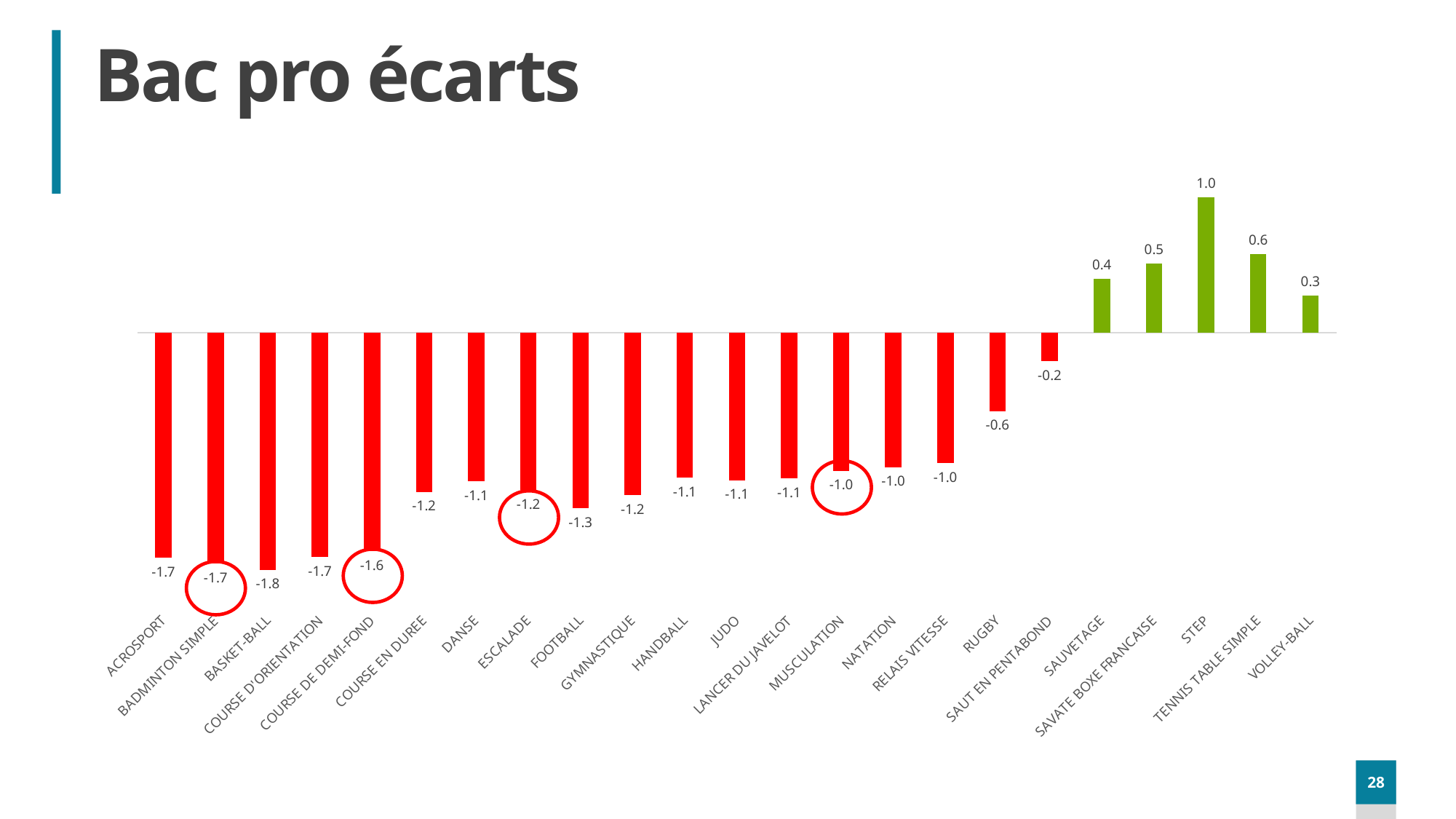
What is the value for RUGBY? -0.6 What is the value for SAUT EN PENTABOND? -0.2 Which category has the lowest value? BASKET-BALL How many categories are shown on the chart? 23 What is the value for FOOTBALL? -1.3 What is the title of the slide? Bac pro écarts What kind of chart is shown on the slide? bar chart Which category has the highest value? STEP Which has a larger value, SAUVETAGE or TENNIS TABLE SIMPLE? TENNIS TABLE SIMPLE What is the value for BASKET-BALL? -1.8 What is the difference between the values for STEP and VOLLEY-BALL? 0.7 What is the value for STEP? 1.0